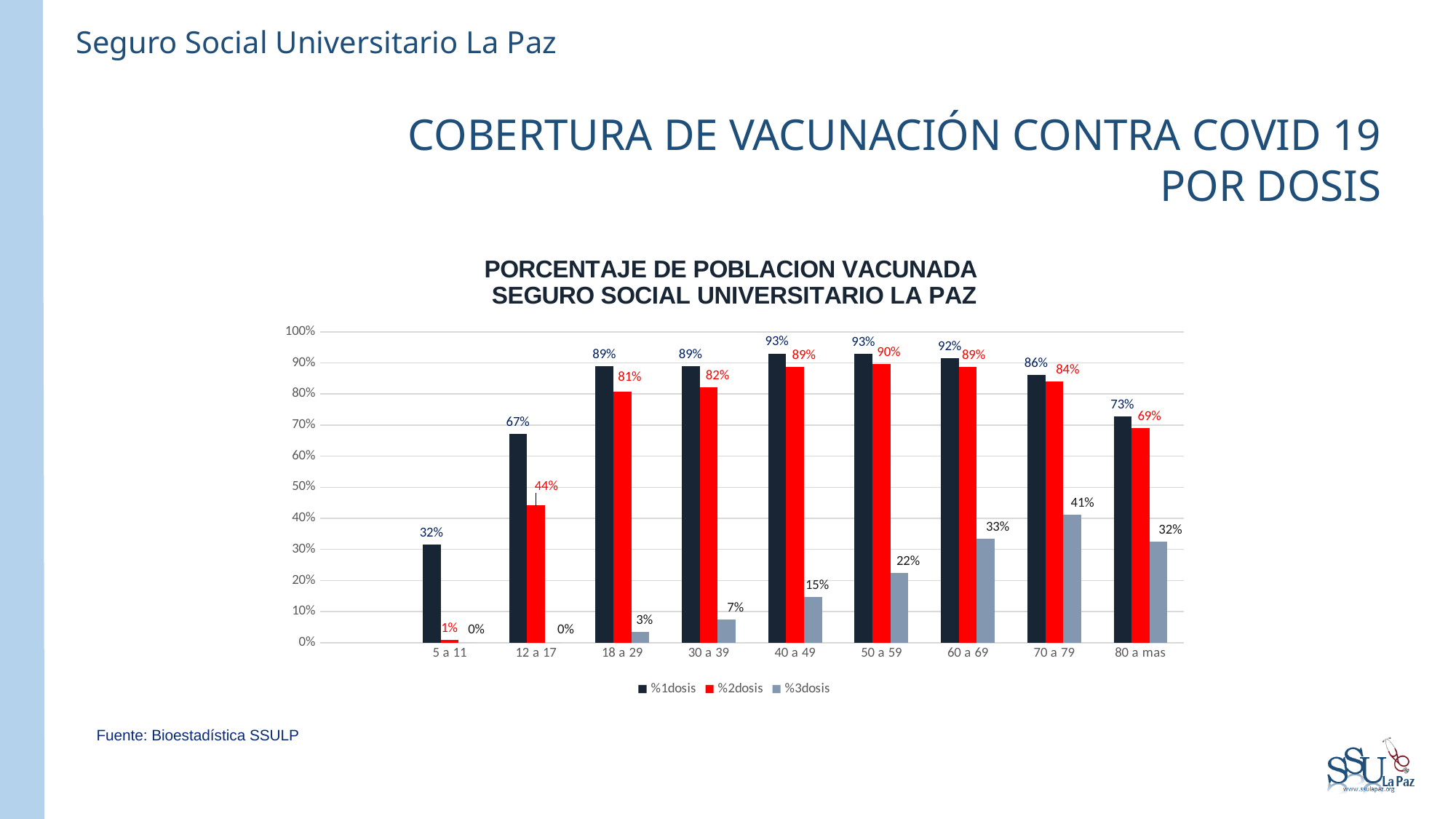
Which age group has the lowest %1dosis value? 5 a 11 What is the difference between the %1dosis and %2dosis values for the 12 a 17 age group? 23% Which is larger for the 60 a 69 age group: the %3dosis value or the %3dosis value for 80 a mas? 60 a 69 What is the %1dosis value for the 80 a mas age group? 73% Which age group has the highest %3dosis value? 70 a 79 What is the %3dosis value for the 70 a 79 age group? 41% Which age group has the highest %2dosis value? 50 a 59 What is the %2dosis value for the 12 a 17 age group? 44% Which colour represents the %2dosis series? Red What type of chart is shown on the slide? Bar chart How many series does the legend list? 3 How many age groups are shown on the x axis? 9